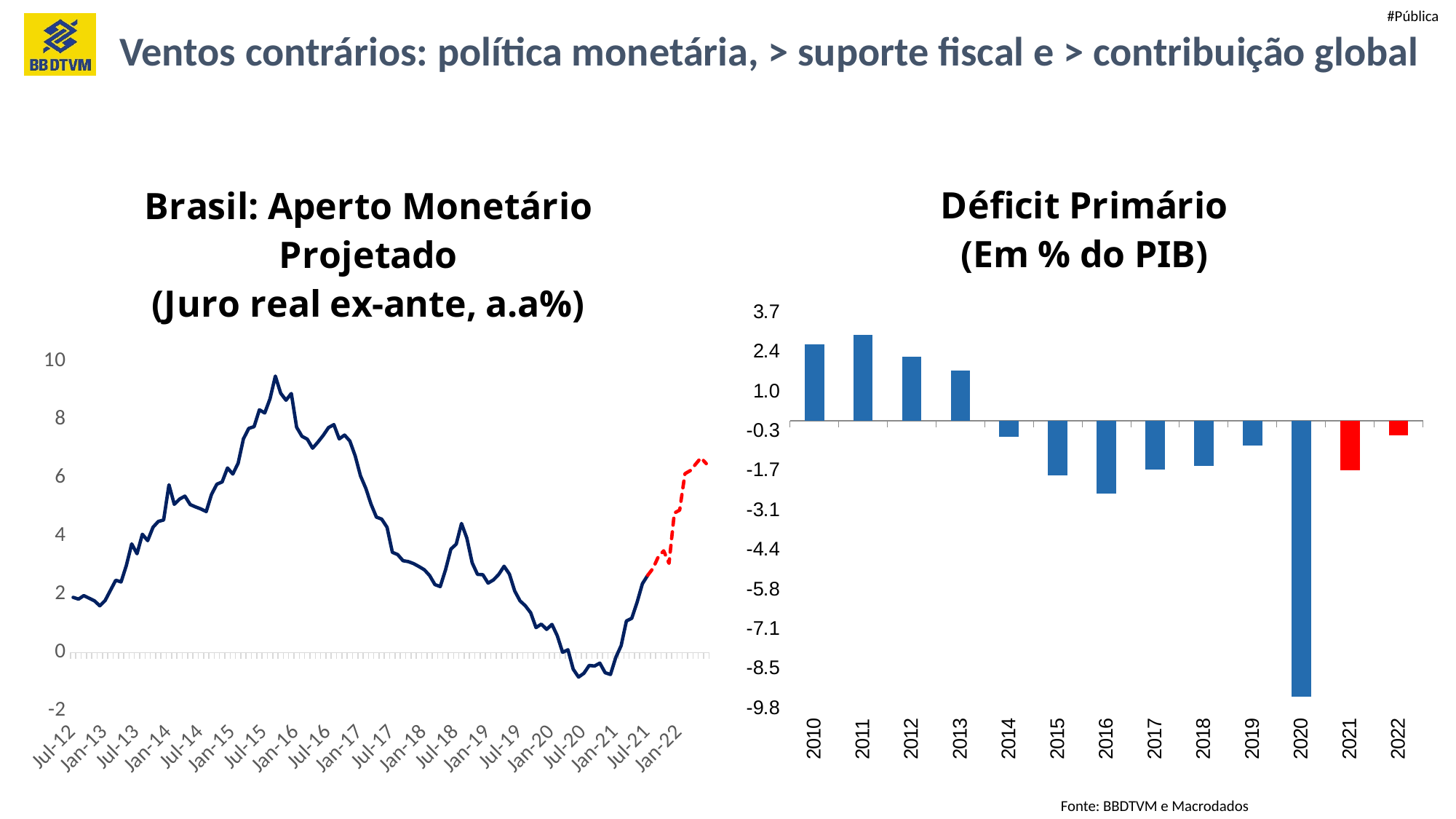
In the 'Déficit Primário' chart, which year has the lowest value? 2020 In the 'Déficit Primário' chart, which is larger, the value for 2015 or the value for 2016? 2015 In the 'Déficit Primário' chart, is the value for 2020 greater or less than -8.5? less In the 'Déficit Primário' chart, which years are shown with red bars? 2021 and 2022 In the 'Déficit Primário' chart, is the value for 2013 greater or less than 1.0? greater In the 'Brasil: Aperto Monetário Projetado' chart, is the value at Jul-20 greater or less than 0? less In the 'Déficit Primário' chart, which year has the highest value? 2011 In the 'Déficit Primário' chart, how many years are shown on the x axis? 13 In the 'Brasil: Aperto Monetário Projetado' chart, do the values rise or fall between Jan-16 and Jul-20? fall What kind of chart is the 'Déficit Primário (Em % do PIB)' chart on the right? bar chart What kind of chart is the 'Brasil: Aperto Monetário Projetado' chart on the left? line chart